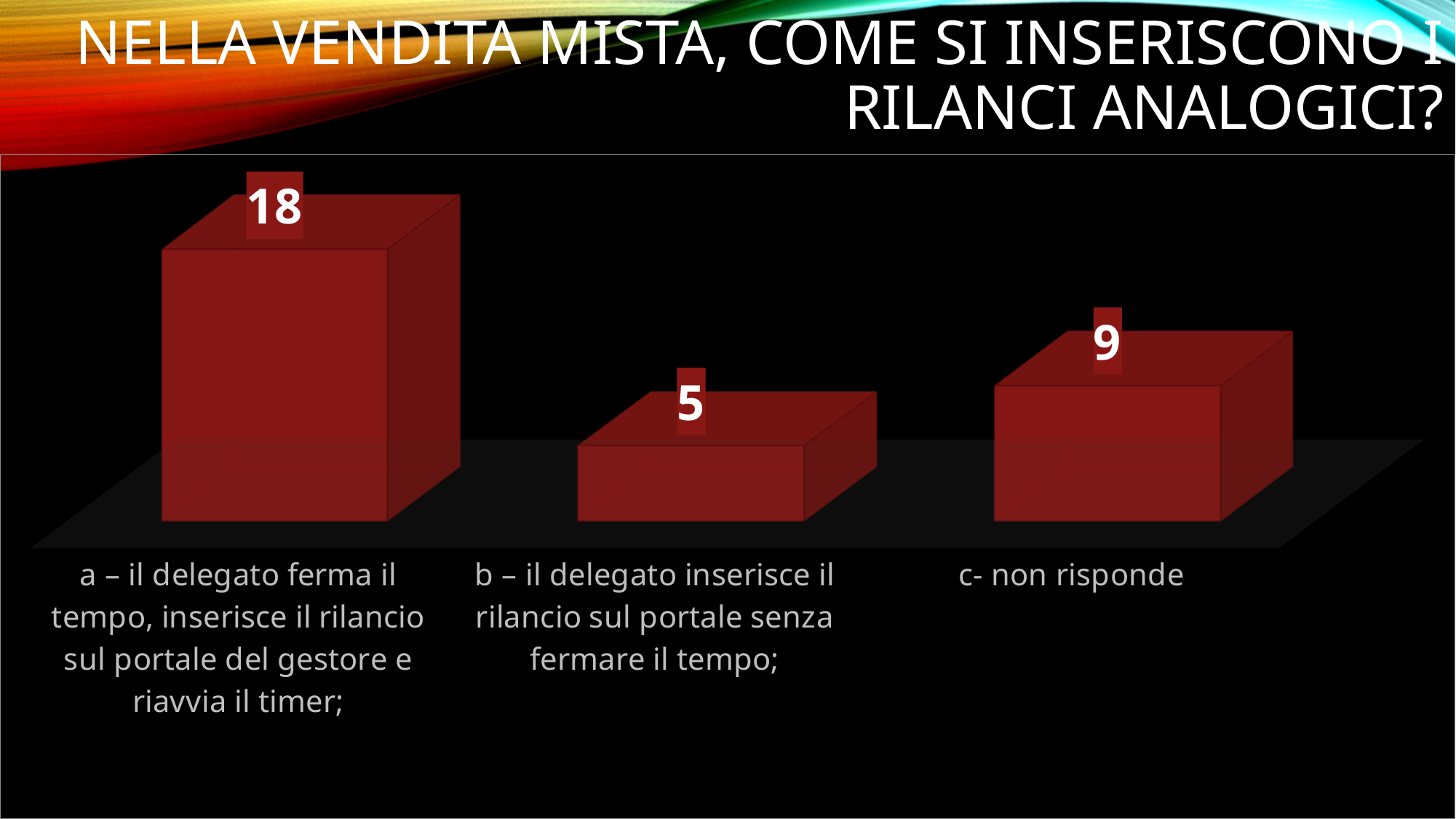
What is the title of the slide containing the chart? Nella vendita mista, come si inseriscono i rilanci analogici? What kind of chart is shown on the slide? Bar chart What is the difference between the value for 'c- non risponde' and the value for option b? 4 Which is larger: the value for option b or the value for 'c- non risponde'? c- non risponde What is the value for option b (il delegato inserisce il rilancio sul portale senza fermare il tempo)? 5 What is the value for option a (il delegato ferma il tempo, inserisce il rilancio sul portale del gestore e riavvia il timer)? 18 How many categories are shown in the chart? 3 What is the difference between the value for option a and the value for option b? 13 Which category has the highest value? a – il delegato ferma il tempo, inserisce il rilancio sul portale del gestore e riavvia il timer What is the total of all three values shown in the chart? 32 Which category has the lowest value? b – il delegato inserisce il rilancio sul portale senza fermare il tempo What is the value for 'c- non risponde'? 9